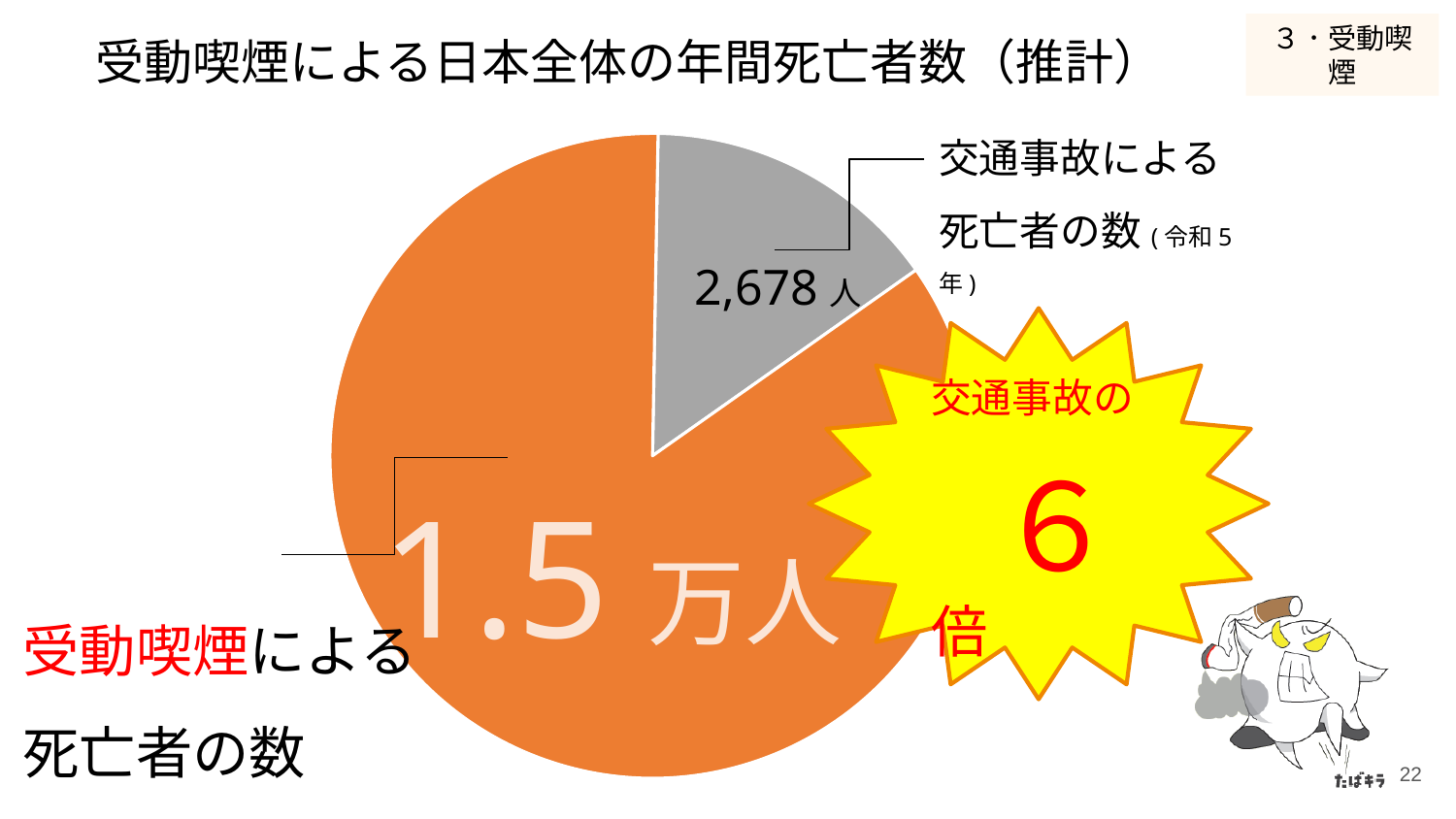
What is the value shown for 交通事故による死亡者の数 in the pie chart? 2,678 人 Which slice of the pie chart is the largest? 受動喫煙による死亡者の数 Which slice of the pie chart is the smallest? 交通事故による死亡者の数 What is the value shown for 受動喫煙による死亡者の数 in the pie chart? 1.5 万人 According to the callout on the slide, passive smoking deaths are how many times the traffic accident deaths? 6 倍 What kind of chart is shown on the slide? Pie chart Which is larger in the pie chart: deaths from 受動喫煙 or deaths from 交通事故? 受動喫煙 What is the title of the chart on the slide? 受動喫煙による日本全体の年間死亡者数（推計） How many slices does the pie chart have? 2 Which year is given for the traffic accident death figure in the pie chart label? 令和5年